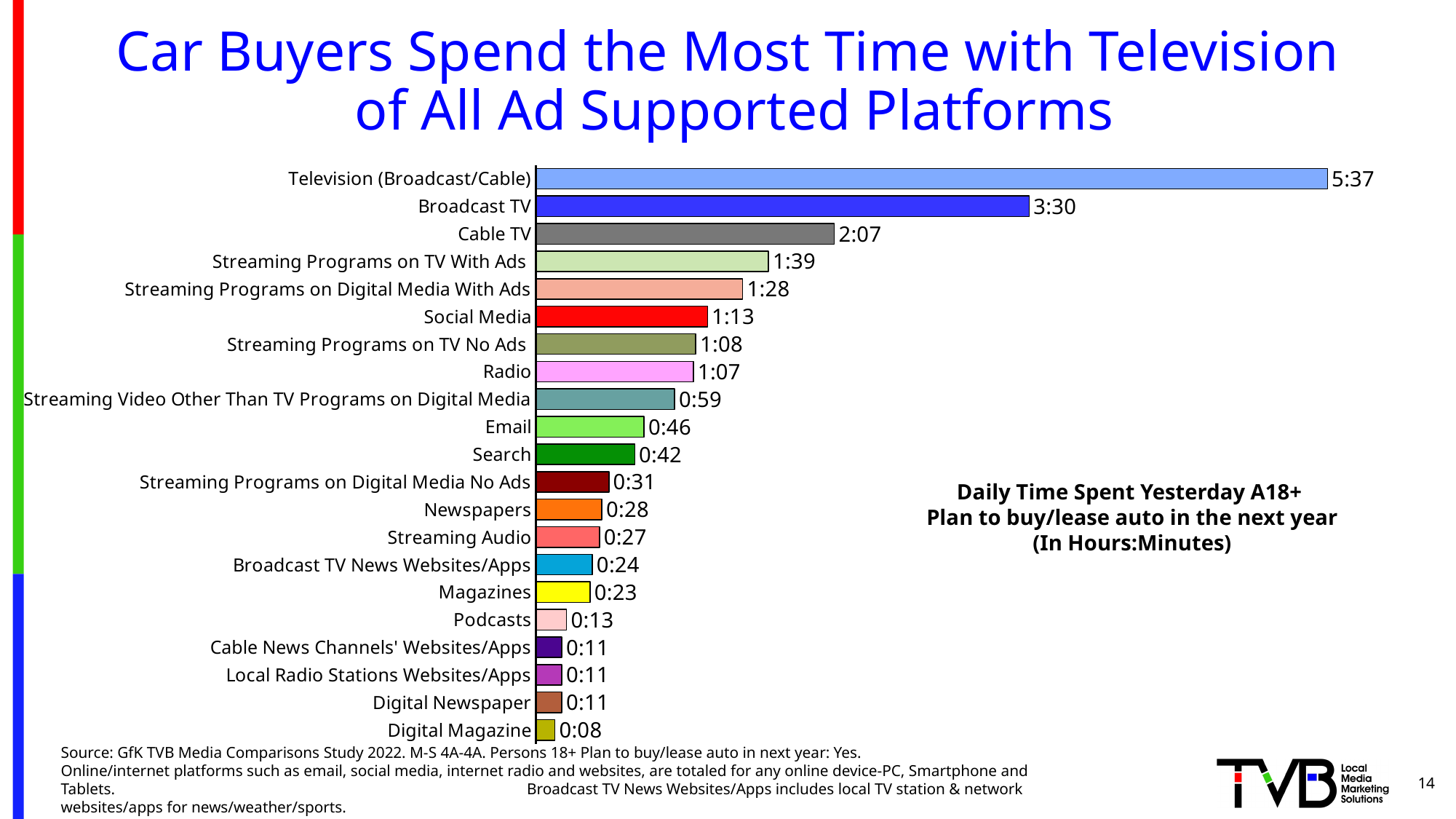
Which is larger, Newspapers or Magazines? Newspapers What is the value shown for Radio? 1:07 Which category has the highest value? Television (Broadcast/Cable) What is the daily time spent with Television (Broadcast/Cable)? 5:37 Which category has the lowest value? Digital Magazine What is the difference between Broadcast TV and Cable TV? 1:23 In what units are the values in the chart expressed? Hours:Minutes What is the difference between Email and Search? 0:04 What is the value shown for Social Media? 1:13 What kind of chart is shown on the slide? Bar chart How many categories are shown in the chart? 21 What is the value shown for Podcasts? 0:13